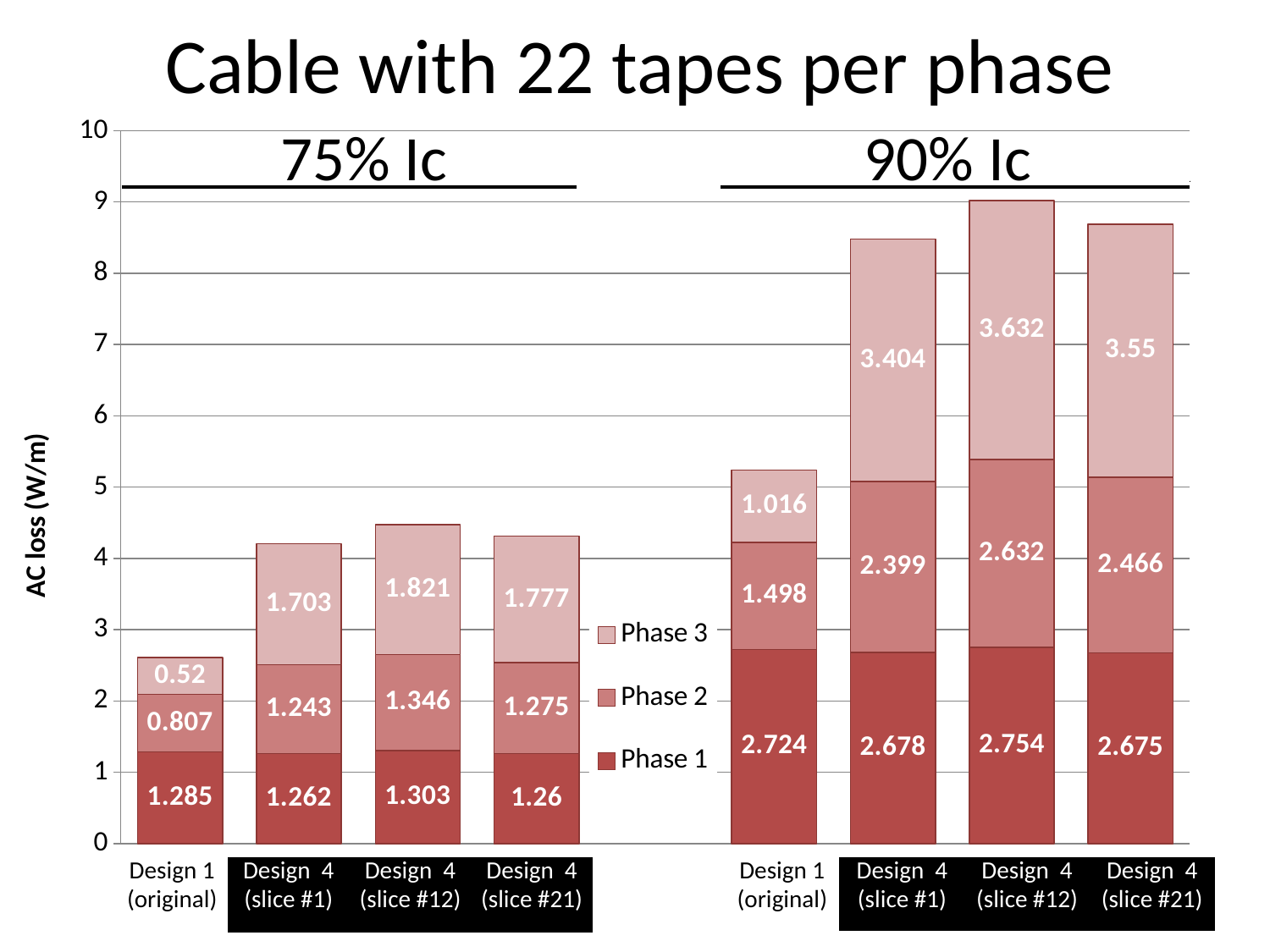
What is the Phase 2 value for Design 4 (slice #21) in the 90% Ic group? 2.466 What is the total AC loss for Design 1 (original) in the 75% Ic group? 2.612 What is the Phase 1 value for Design 1 (original) in the 75% Ic group? 1.285 Which bar in the 75% Ic group has the lowest Phase 2 value? Design 1 (original) How many stacked bars are plotted in the chart? 8 What is the difference between the Phase 3 values of Design 4 (slice #1) in the 90% Ic group and in the 75% Ic group? 1.701 What is the Phase 3 value for Design 4 (slice #12) in the 90% Ic group? 3.632 Is the Phase 1 value for Design 1 (original) larger in the 75% Ic group or the 90% Ic group? 90% Ic Which bar in the 90% Ic group has the highest Phase 3 value? Design 4 (slice #12) What type of chart is shown on the slide? Stacked bar chart Is the total AC loss for Design 4 (slice #12) in the 90% Ic group greater or less than 8? greater How many series does the legend list? 3